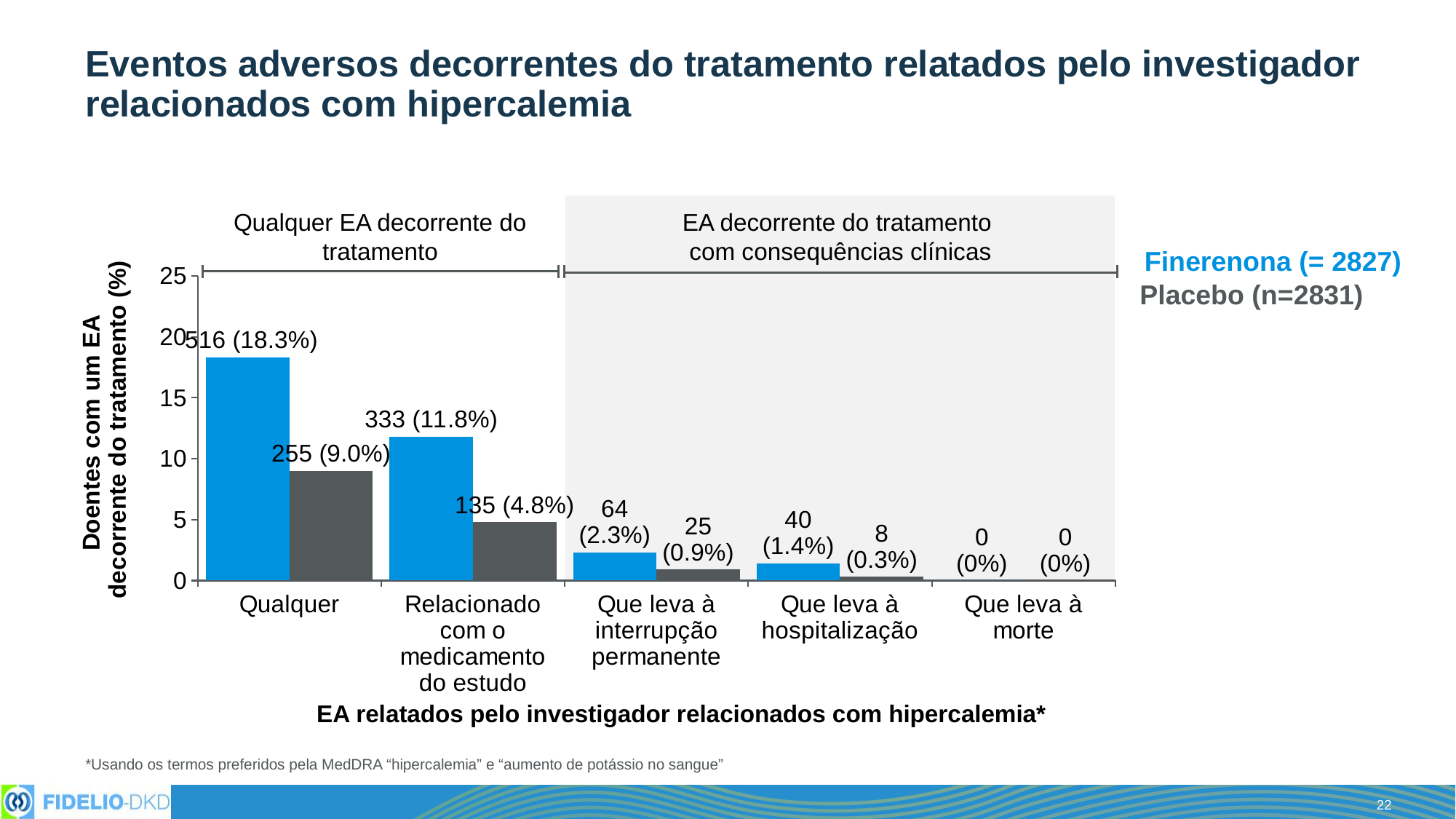
Which category has the highest value for Finerenona? Qualquer What is the difference in patient counts between Finerenona and Placebo in the 'Qualquer' category? 261 What is the data label for Finerenona in the 'Qualquer' category? 516 (18.3%) What is the data label for Finerenona in the 'Relacionado com o medicamento do estudo' category? 333 (11.8%) What is the data label for Placebo in the 'Qualquer' category? 255 (9.0%) What type of chart is shown on the slide? Bar chart What percentage is shown for Finerenona in the 'Que leva à interrupção permanente' category? 2.3% How many series does the chart show? 2 What is the data label for Placebo in the 'Que leva à hospitalização' category? 8 (0.3%) Which is larger in the 'Relacionado com o medicamento do estudo' category, Finerenona or Placebo? Finerenona How many categories are shown on the x axis? 5 Which category has the lowest value for Placebo? Que leva à morte